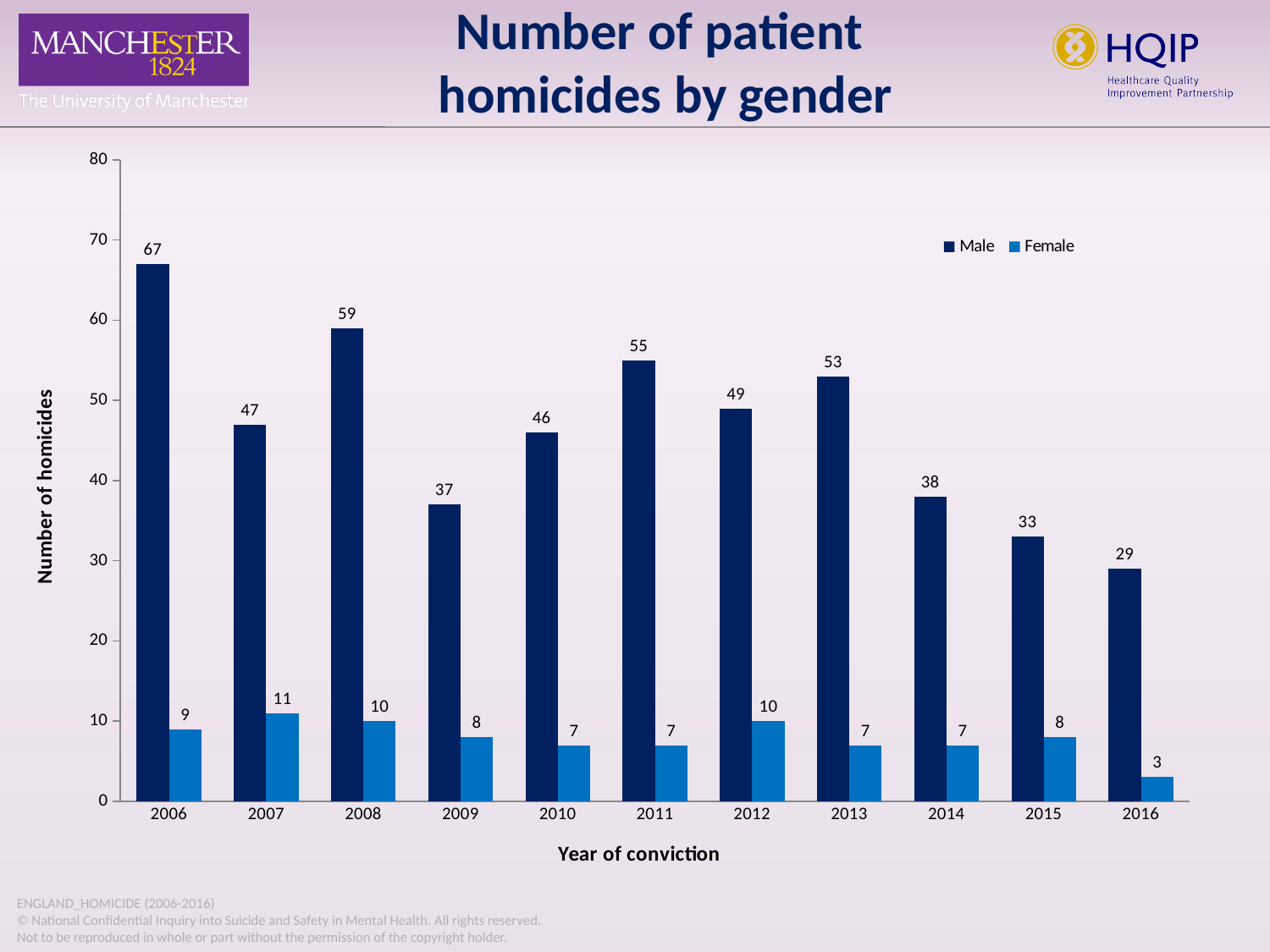
Which year has the highest number of male patient homicides? 2006 What is the number of female patient homicides in 2007? 11 What is the number of male patient homicides in 2006? 67 Which is larger, the number of male homicides in 2008 or in 2011? 2008 What is the label of the y axis? Number of homicides Which year has the lowest number of female patient homicides? 2016 What kind of chart is shown on the slide? Bar chart What is the difference between male and female patient homicides in 2016? 26 What is the number of male patient homicides in 2013? 53 Do the male patient homicide values generally rise or fall from 2013 to 2016? Fall How many years are shown on the x axis? 11 How many series does the legend list? 2